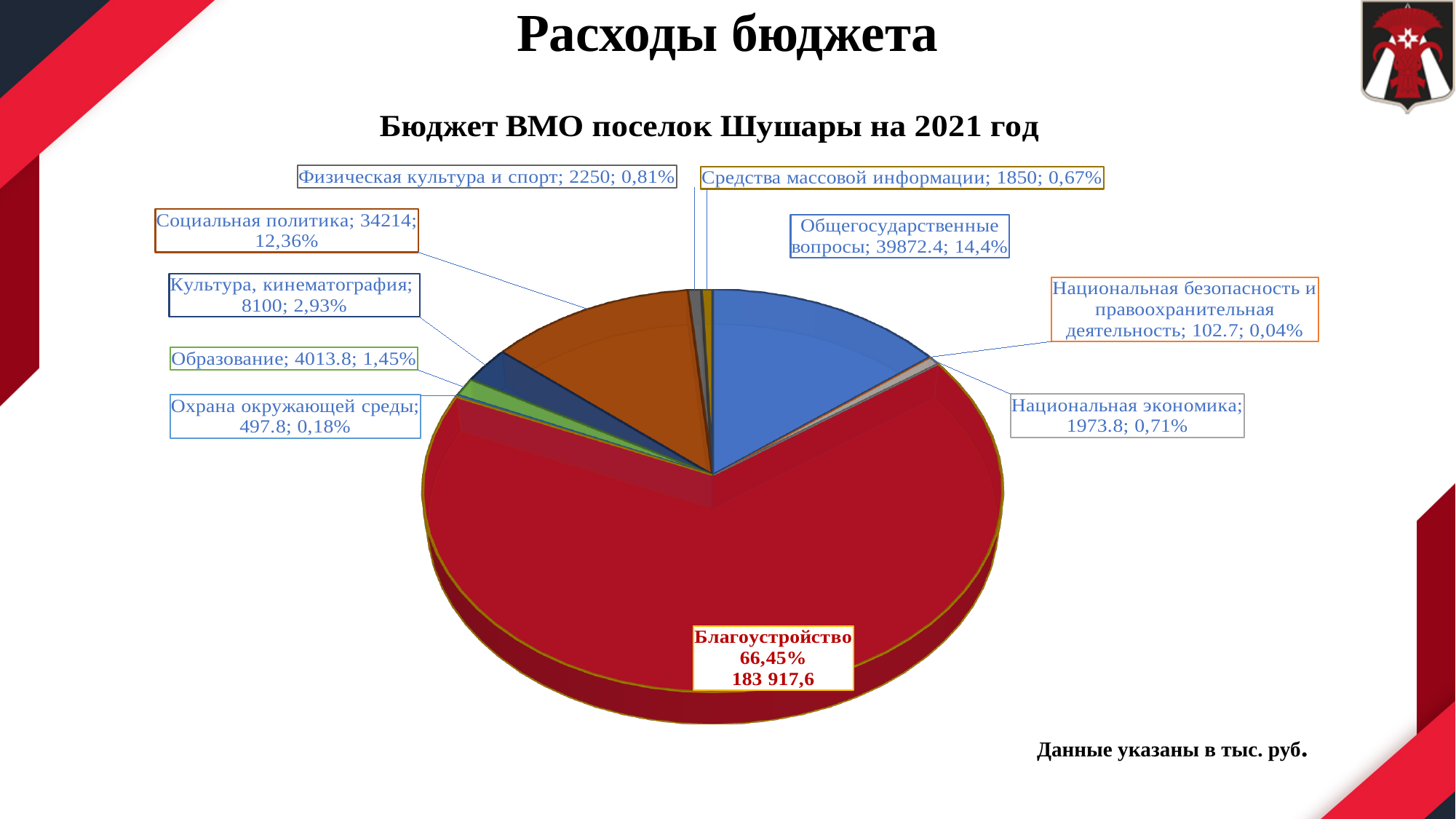
What is the value for Социальная политика? 34214 Which is larger: the value for Физическая культура и спорт or the value for Средства массовой информации? Физическая культура и спорт What is the title of the chart? Бюджет ВМО поселок Шушары на 2021 год What is the difference between the values for Образование and Охрана окружающей среды? 3516 What is the value for Национальная экономика? 1973.8 Which category has the smallest share of the budget? Национальная безопасность и правоохранительная деятельность Which category has the largest share of the budget? Благоустройство What share of the budget does Общегосударственные вопросы account for? 14,4% What percentage share does Культура, кинематография have? 2,93% What is the value for Благоустройство? 183 917,6 How many categories (slices) does the pie chart have? 10 What kind of chart is shown on the slide? pie chart